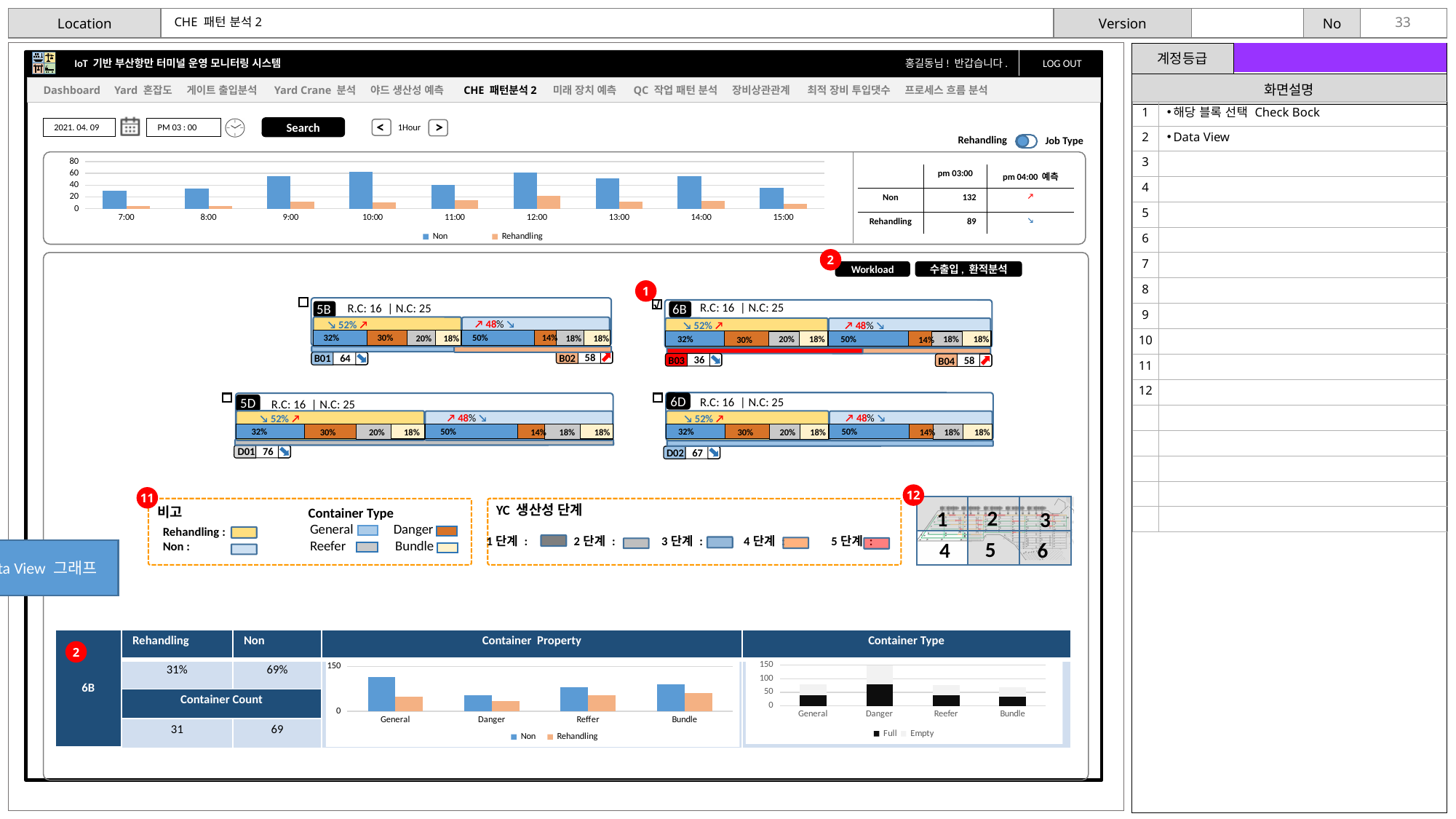
In the Container Property chart, which category has the highest Non bar? General In the Container Property chart, which is larger for General: Non or Rehandling? Non In the top hourly chart, is the Rehandling value at 7:00 greater or less than 20? less In the top hourly chart, how many series does the legend list? 2 In the top hourly chart, at which time is the Rehandling bar highest? 12:00 In the top hourly chart, how many time categories are shown on the x axis? 9 In the Container Type chart, which category has the tallest stacked bar? Danger In the Container Type chart, what two series does the legend list? Full, Empty In the 6B summary table at the bottom left, what is the Rehandling percentage? 31% What kind of chart is the Container Property chart at the bottom of the slide? bar chart In the Container Type chart, is the Full value for Danger greater or less than 50? greater In the top hourly chart, is the Non value at 10:00 greater or less than 40? greater